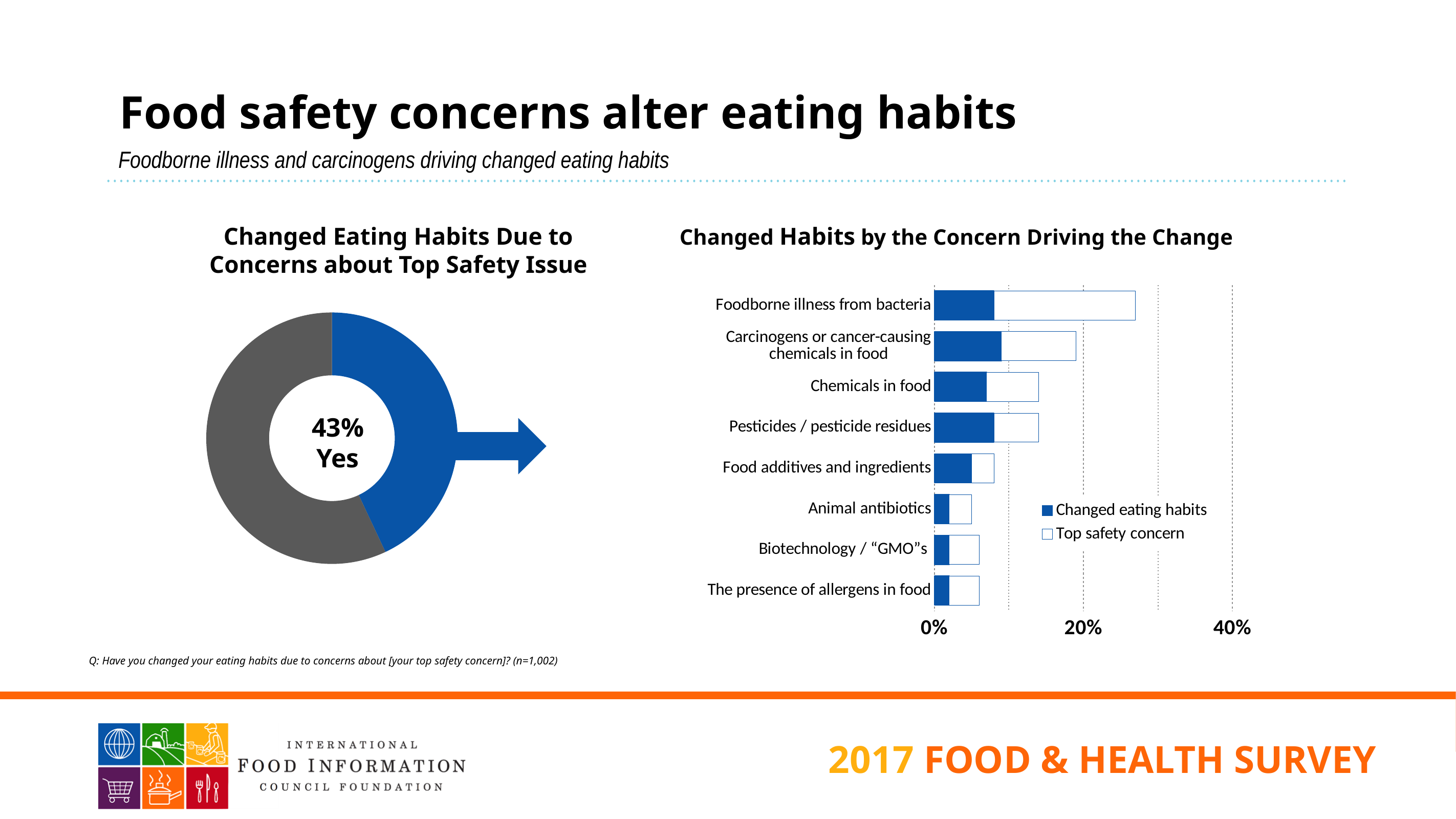
In the chart 'Changed Habits by the Concern Driving the Change', which has the larger 'Top safety concern' value: Foodborne illness from bacteria or Animal antibiotics? Foodborne illness from bacteria In the chart 'Changed Habits by the Concern Driving the Change', what is the highest value shown on the x axis? 40% How many concern categories are shown in the chart 'Changed Habits by the Concern Driving the Change'? 8 In the chart 'Changed Habits by the Concern Driving the Change', is the 'Changed eating habits' value for Foodborne illness from bacteria greater or less than 20%? less What kind of chart is 'Changed Habits by the Concern Driving the Change'? Bar chart In the chart 'Changed Eating Habits Due to Concerns about Top Safety Issue', what percentage answered Yes? 43% What kind of chart is 'Changed Eating Habits Due to Concerns about Top Safety Issue'? Donut (pie) chart In the chart 'Changed Habits by the Concern Driving the Change', is the 'Top safety concern' value for Chemicals in food greater or less than 20%? less In the chart 'Changed Habits by the Concern Driving the Change', which concern has the highest 'Top safety concern' value? Foodborne illness from bacteria In the chart 'Changed Habits by the Concern Driving the Change', what are the two legend entries? Changed eating habits; Top safety concern How many series does the legend list in the chart 'Changed Habits by the Concern Driving the Change'? 2